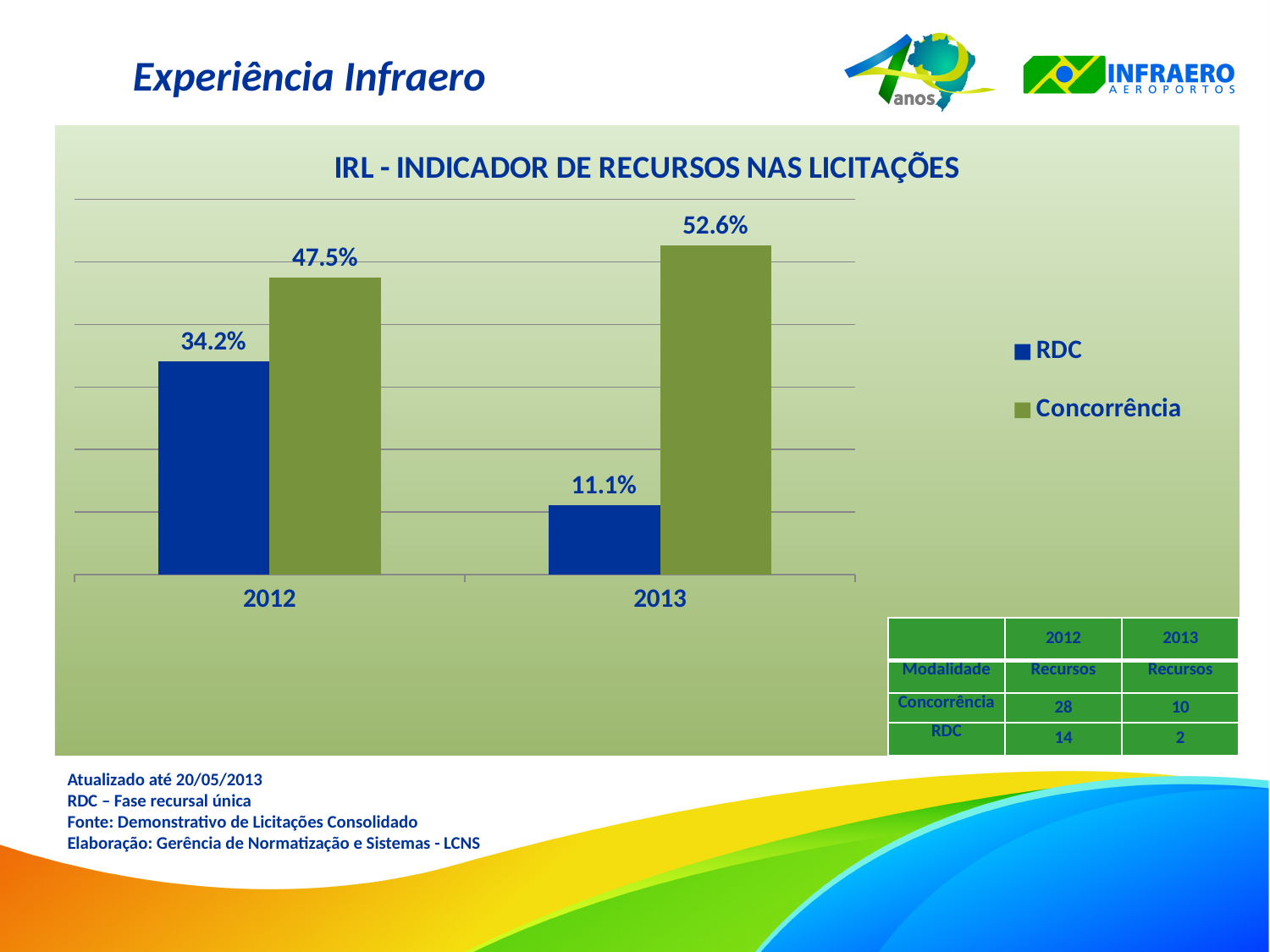
Which bar has the lowest value in the chart? RDC in 2013 How does the RDC value change from 2012 to 2013? It falls Which bar has the highest value in the chart? Concorrência in 2013 What is the difference between the Concorrência and RDC values in 2012? 13.3 percentage points What is the value for RDC in 2013? 11.1% What is the value for Concorrência in 2013? 52.6% What type of chart is shown on the slide? Bar chart How many series does the legend list? 2 Which is larger in 2013, RDC or Concorrência? Concorrência What is the value for RDC in 2012? 34.2% What is the value for Concorrência in 2012? 47.5% By how much did the RDC value fall from 2012 to 2013? 23.1 percentage points